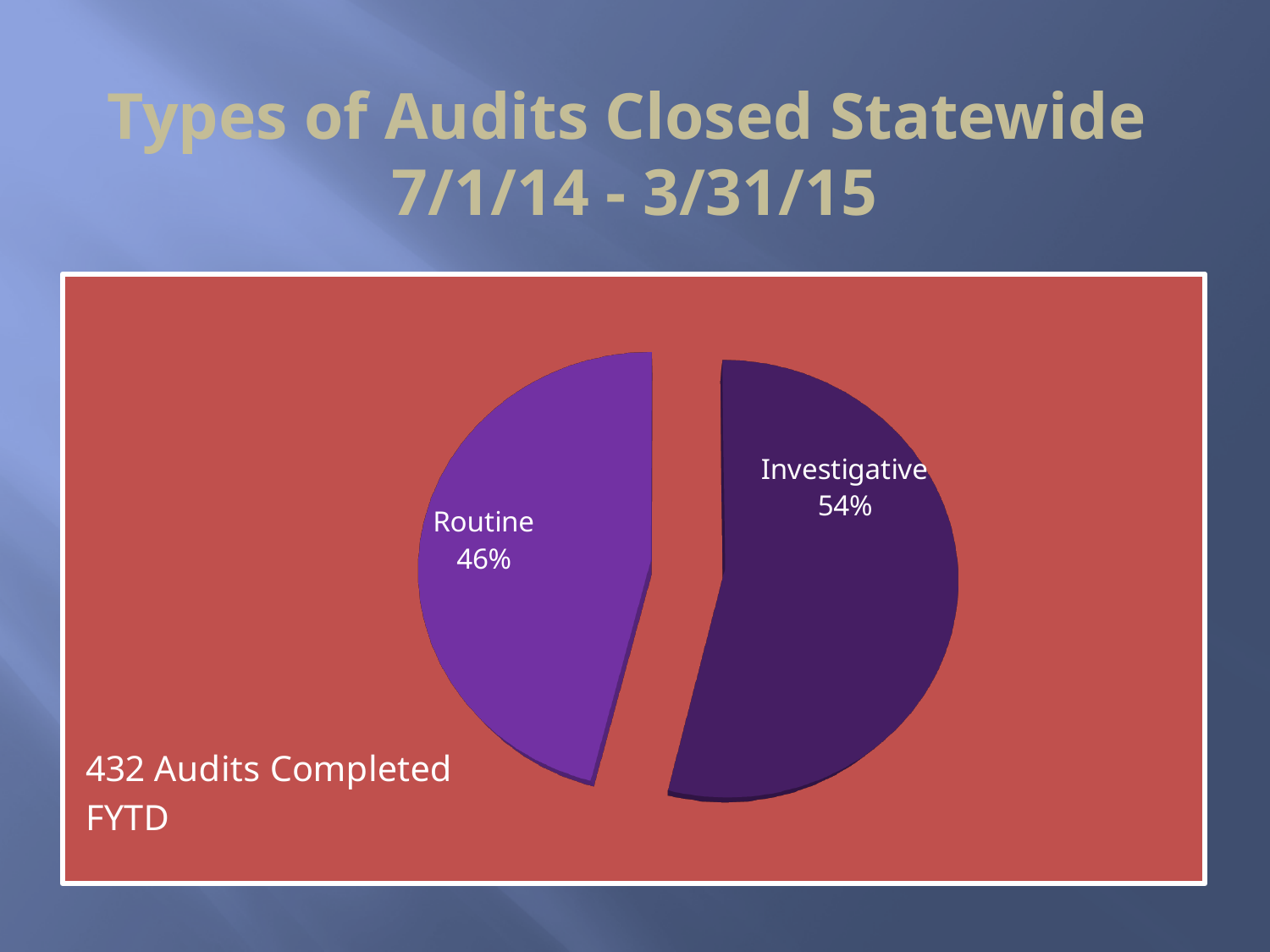
Which slice of the pie is the smallest? Routine What share of the pie does the Investigative slice represent? 54% Which slice of the pie is the largest? Investigative What is the difference in percentage points between the Investigative and Routine slices? 8 How many slices does the pie chart have? 2 What kind of chart is shown on the slide? pie chart Which is larger, the Routine slice or the Investigative slice? Investigative What share of the pie does the Routine slice represent? 46% What is the title of the chart on the slide? Types of Audits Closed Statewide 7/1/14 - 3/31/15 Is the value for Investigative greater or less than 50%? greater How many audits were completed FYTD according to the text on the chart? 432 Is the value for Routine greater or less than 50%? less